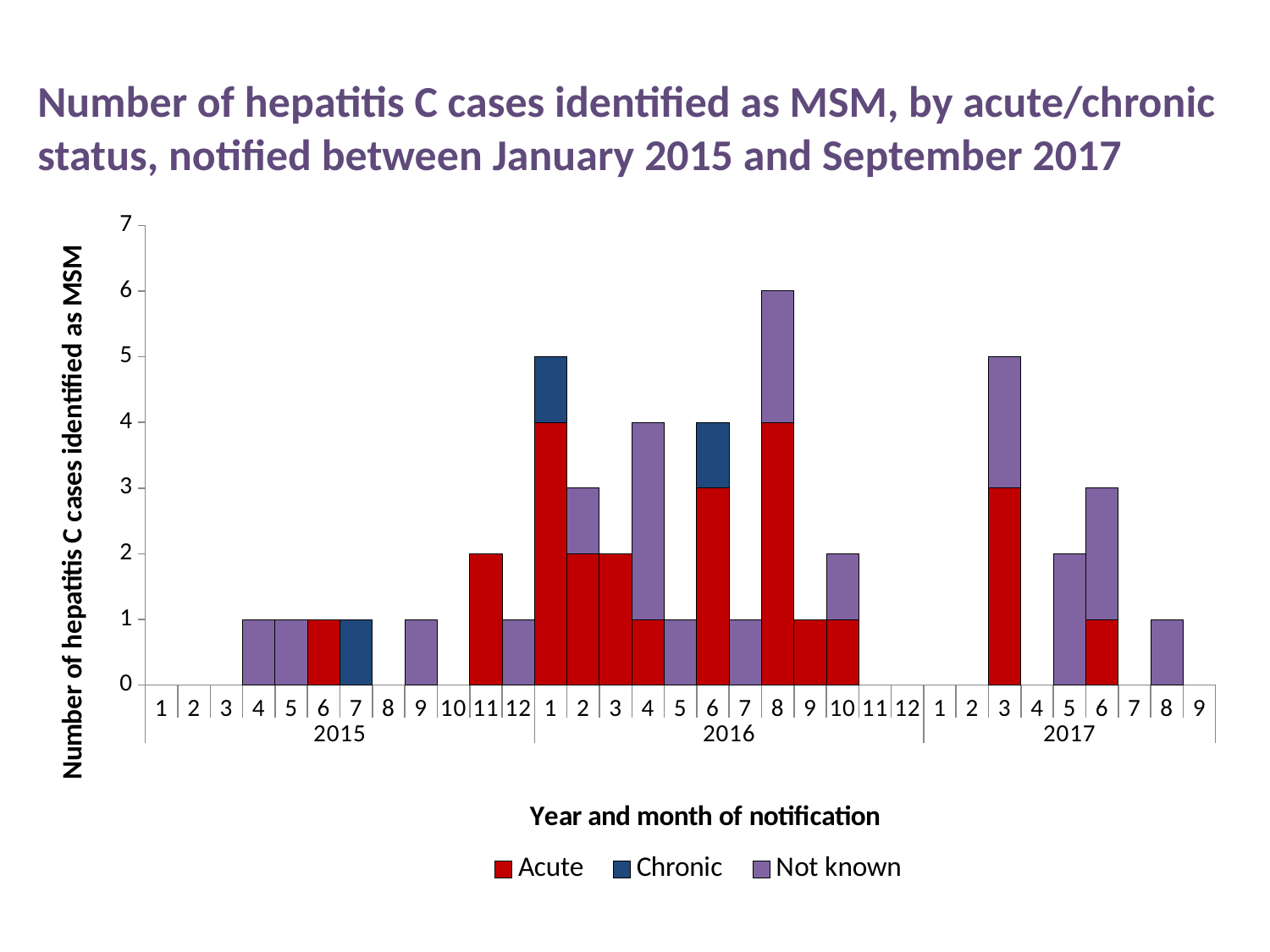
Which colour represents the 'Chronic' series in the legend? blue How many series does the legend list? 3 What is the label of the y axis? Number of hepatitis C cases identified as MSM Which is larger: the total number of cases in January 2016 or in June 2016? January 2016 Which month has the highest total number of hepatitis C cases identified as MSM? August 2016 What is the total number of cases notified in March 2017? 5 How many chronic cases were notified in June 2016? 1 What is the total number of cases notified in August 2016? 6 How many 'Not known' cases were notified in April 2016? 3 What type of chart is shown on the slide? stacked bar chart How many acute cases were notified in January 2016? 4 What is the difference between the total cases in August 2016 and the total cases in October 2016? 4